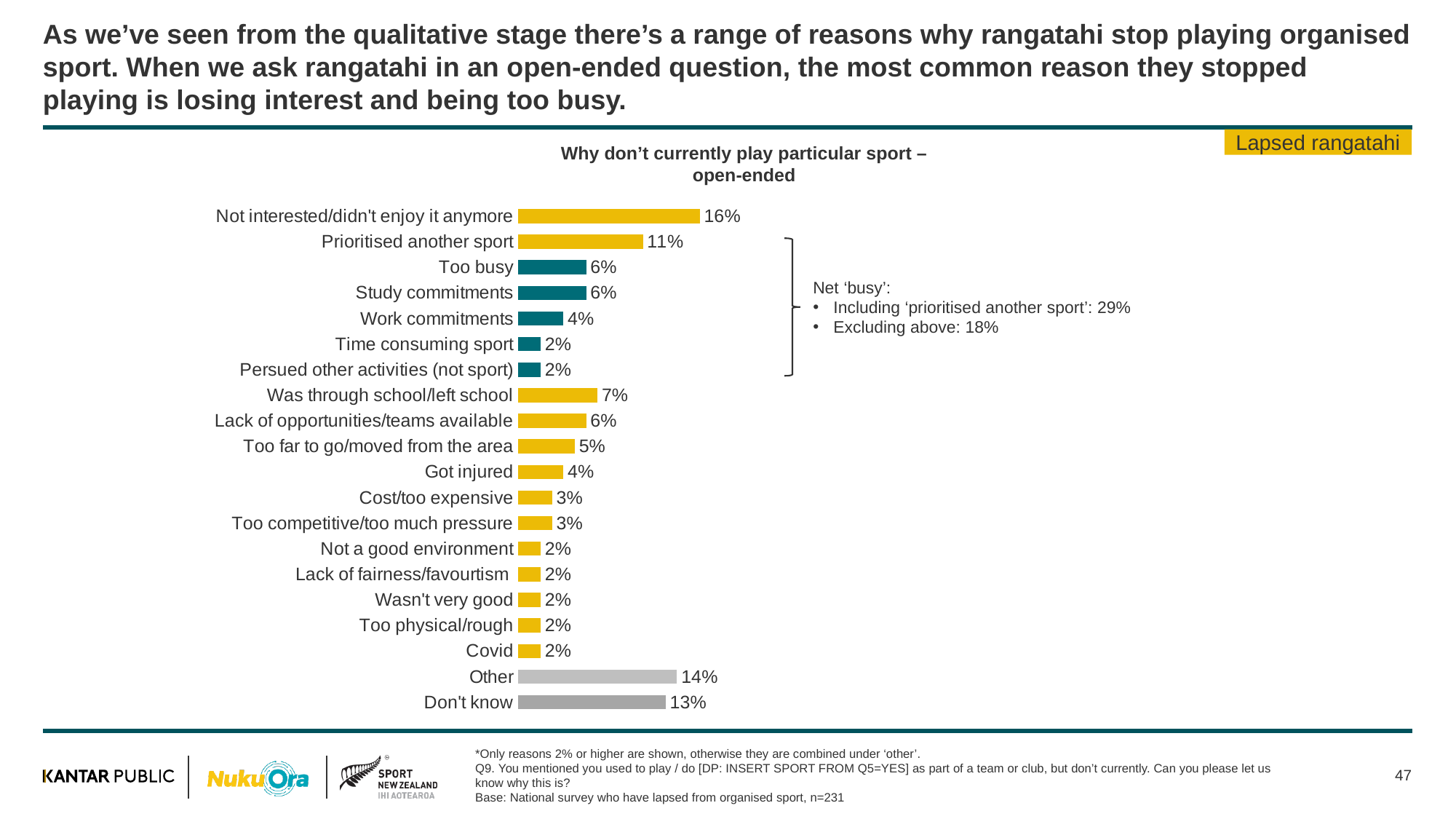
Which is larger: 'Other' or 'Don't know'? Other What percentage of lapsed rangatahi said they were not interested/didn't enjoy it anymore? 16% What is the value for 'Prioritised another sport'? 11% Which reason has the highest percentage in the chart? Not interested/didn't enjoy it anymore What is the value shown for 'Don't know'? 13% How many reason categories are plotted in the chart? 20 Which is larger: 'Too far to go/moved from the area' or 'Got injured'? Too far to go/moved from the area What is the difference between 'Not interested/didn't enjoy it anymore' and 'Prioritised another sport'? 5 percentage points What is the net 'busy' percentage including 'prioritised another sport', as annotated on the chart? 29% What is the title of the chart? Why don't currently play particular sport – open-ended What percentage gave 'Was through school/left school' as a reason? 7% What type of chart is shown on the slide? Bar chart